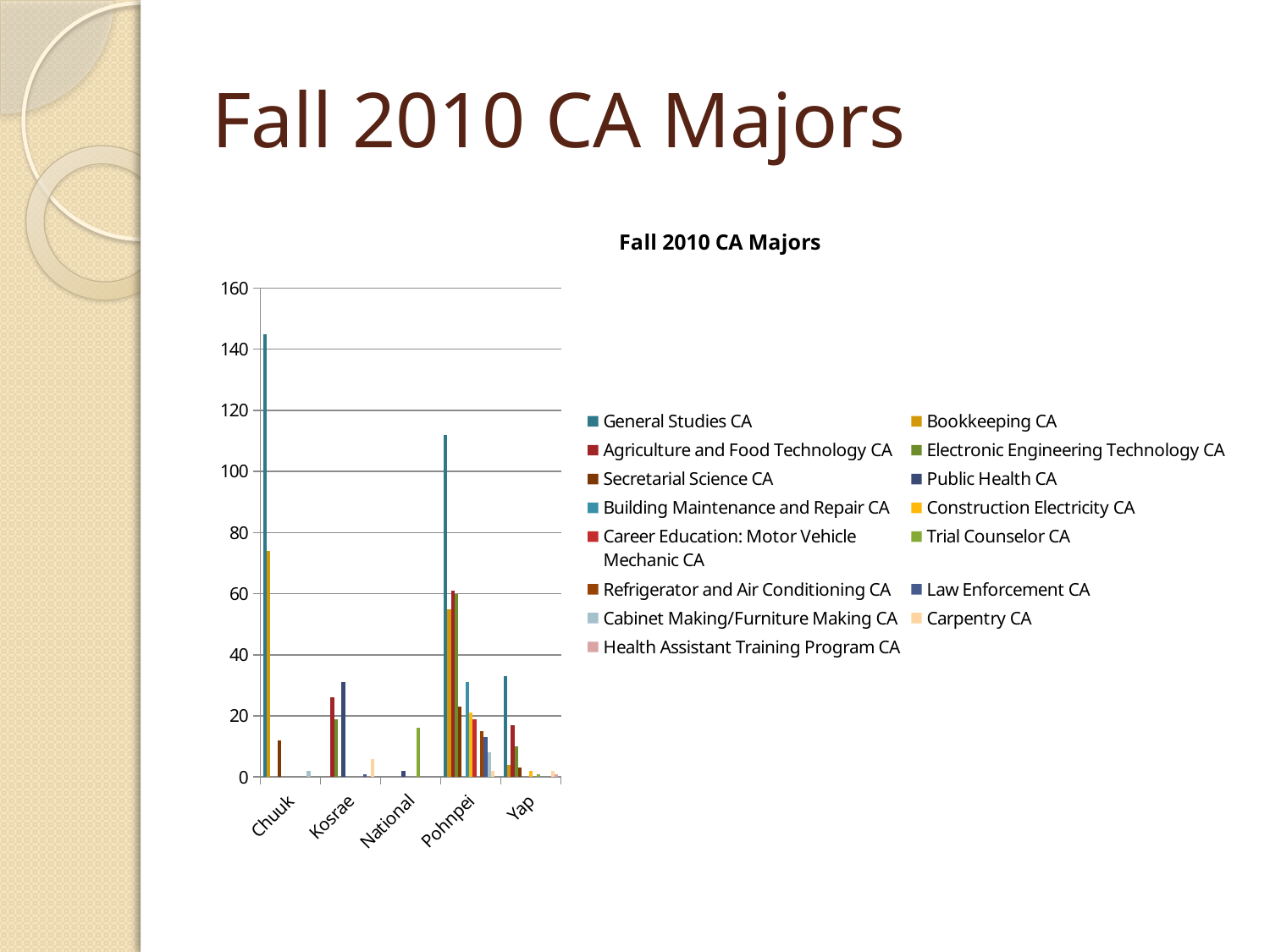
Which category has the tallest bar in the chart? Chuuk Which has a larger General Studies CA value, Chuuk or Pohnpei? Chuuk What type of chart is shown on the slide? bar chart Which has a larger General Studies CA value, Pohnpei or Yap? Pohnpei How many categories are shown on the x axis of the chart? 5 Which category has the lowest overall bars in the chart? National Is the Bookkeeping CA value for Chuuk greater or less than 60? greater Is the General Studies CA value for Chuuk greater or less than 140? greater How many series does the chart's legend list? 15 Is the General Studies CA value for Yap greater or less than 40? less What is the title of the chart? Fall 2010 CA Majors